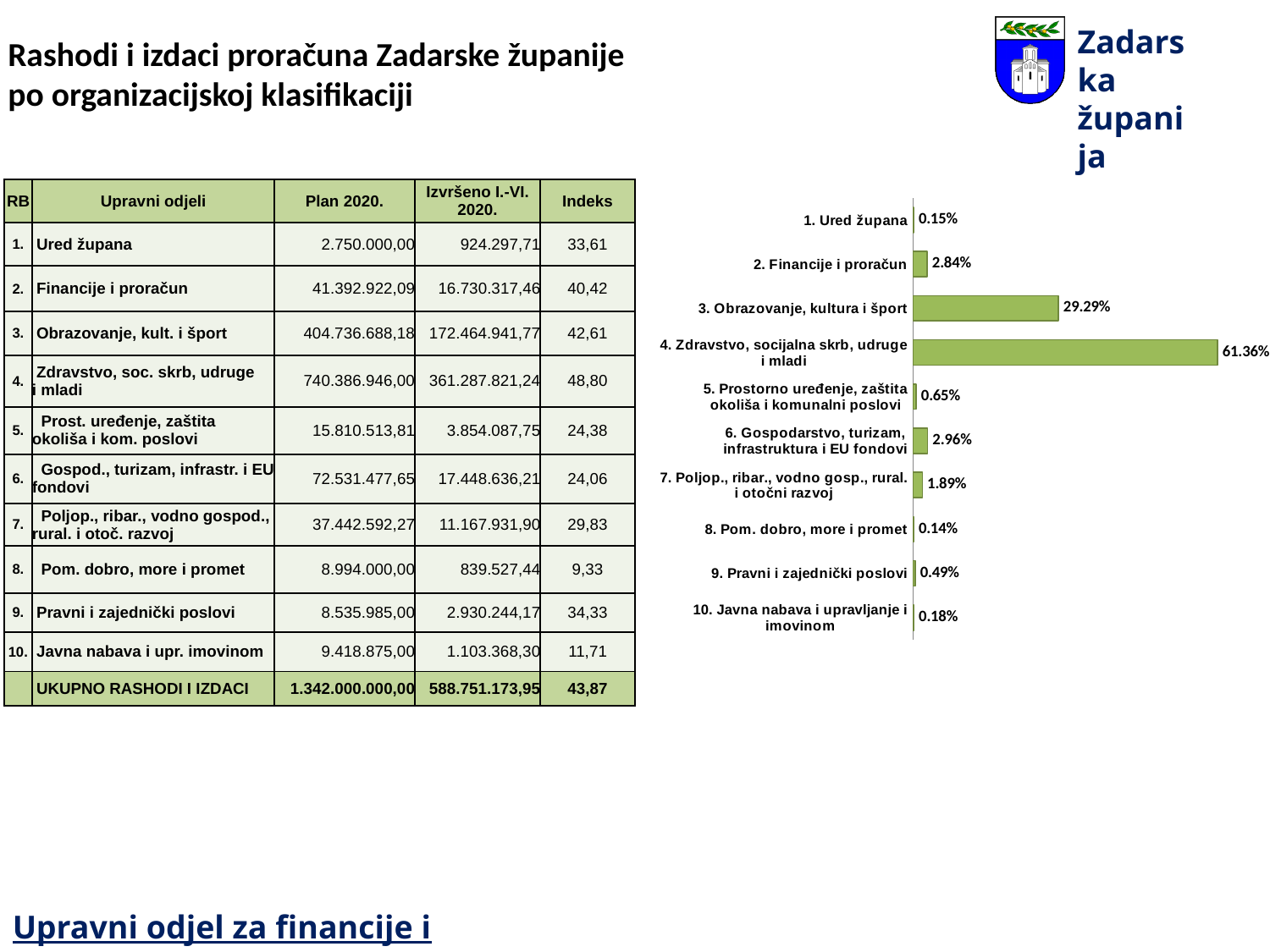
What is the value shown for '5. Prostorno uređenje, zaštita okoliša i komunalni poslovi' in the bar chart? 0.65% Which category has the highest value in the bar chart? 4. Zdravstvo, socijalna skrb, udruge i mladi What is the value shown for '3. Obrazovanje, kultura i šport' in the bar chart? 29.29% What is the value shown for '4. Zdravstvo, socijalna skrb, udruge i mladi' in the bar chart? 61.36% What is the value shown for '7. Poljop., ribar., vodno gosp., rural. i otočni razvoj' in the bar chart? 1.89% What is the difference between the values for '4. Zdravstvo, socijalna skrb, udruge i mladi' and '3. Obrazovanje, kultura i šport' in the bar chart? 32.07% Which category has the lowest value in the bar chart? 8. Pom. dobro, more i promet How many categories does the bar chart show? 10 What kind of chart is shown on the right side of the slide? bar chart In the bar chart, which has the larger value: '6. Gospodarstvo, turizam, infrastruktura i EU fondovi' or '2. Financije i proračun'? 6. Gospodarstvo, turizam, infrastruktura i EU fondovi What is the value shown for '2. Financije i proračun' in the bar chart? 2.84% What is the value shown for '9. Pravni i zajednički poslovi' in the bar chart? 0.49%